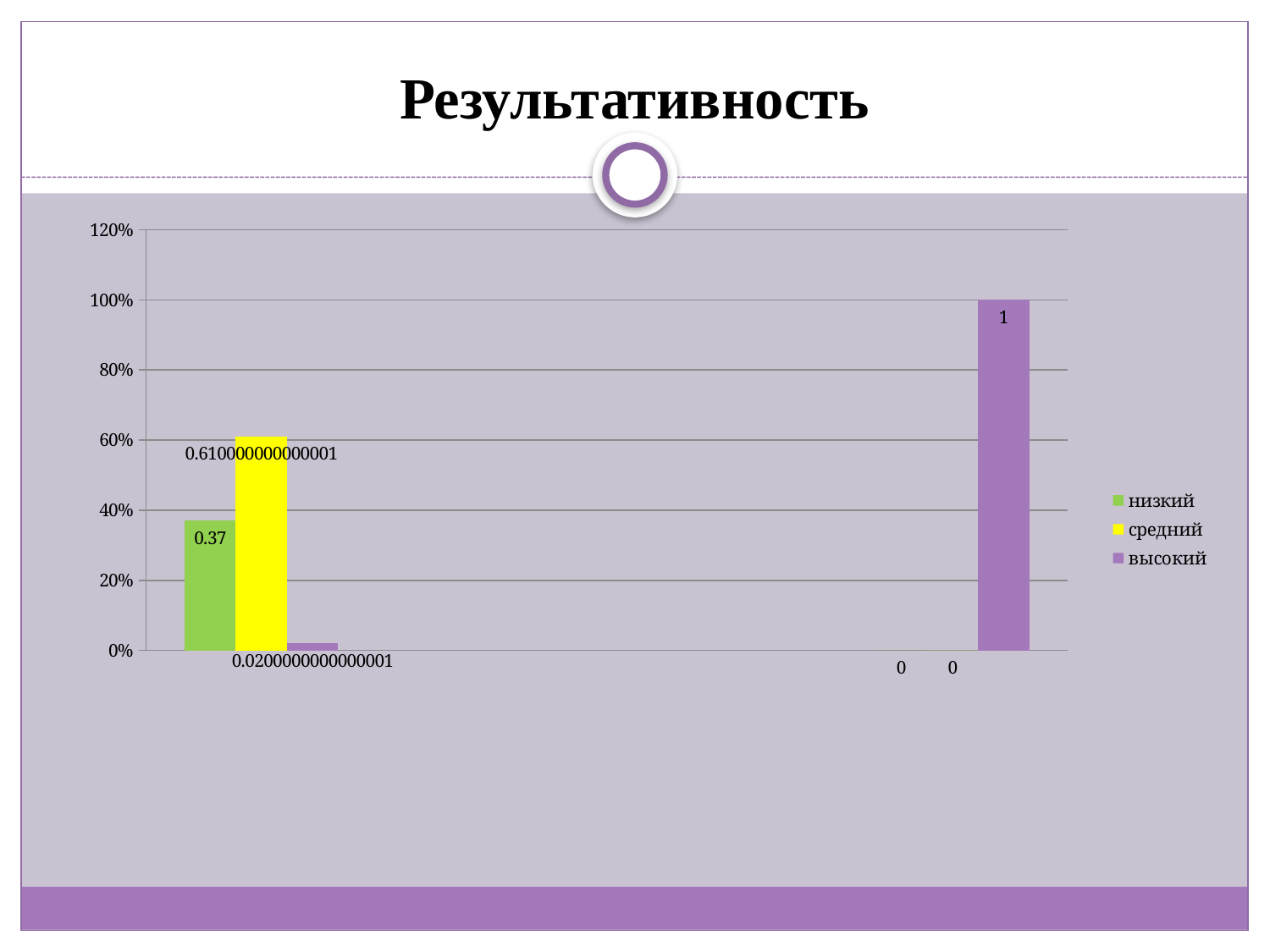
What is the value of the высокий series in the right group of bars? 1 Which series has the highest value in the left group of bars? средний What kind of chart is shown on the slide? bar chart What is the value of the средний series in the left group of bars? 0.610000000000001 What is the value of the низкий series in the right group of bars? 0 What is the title of the chart? Результативность How many series does the legend list? 3 Is the value of the низкий series in the left group greater or less than 40%? less What is the value of the высокий series in the left group of bars? 0.0200000000000001 Which series has the lowest value in the left group of bars? высокий What is the value of the низкий series in the left group of bars? 0.37 Which series is shown in yellow in the legend? средний